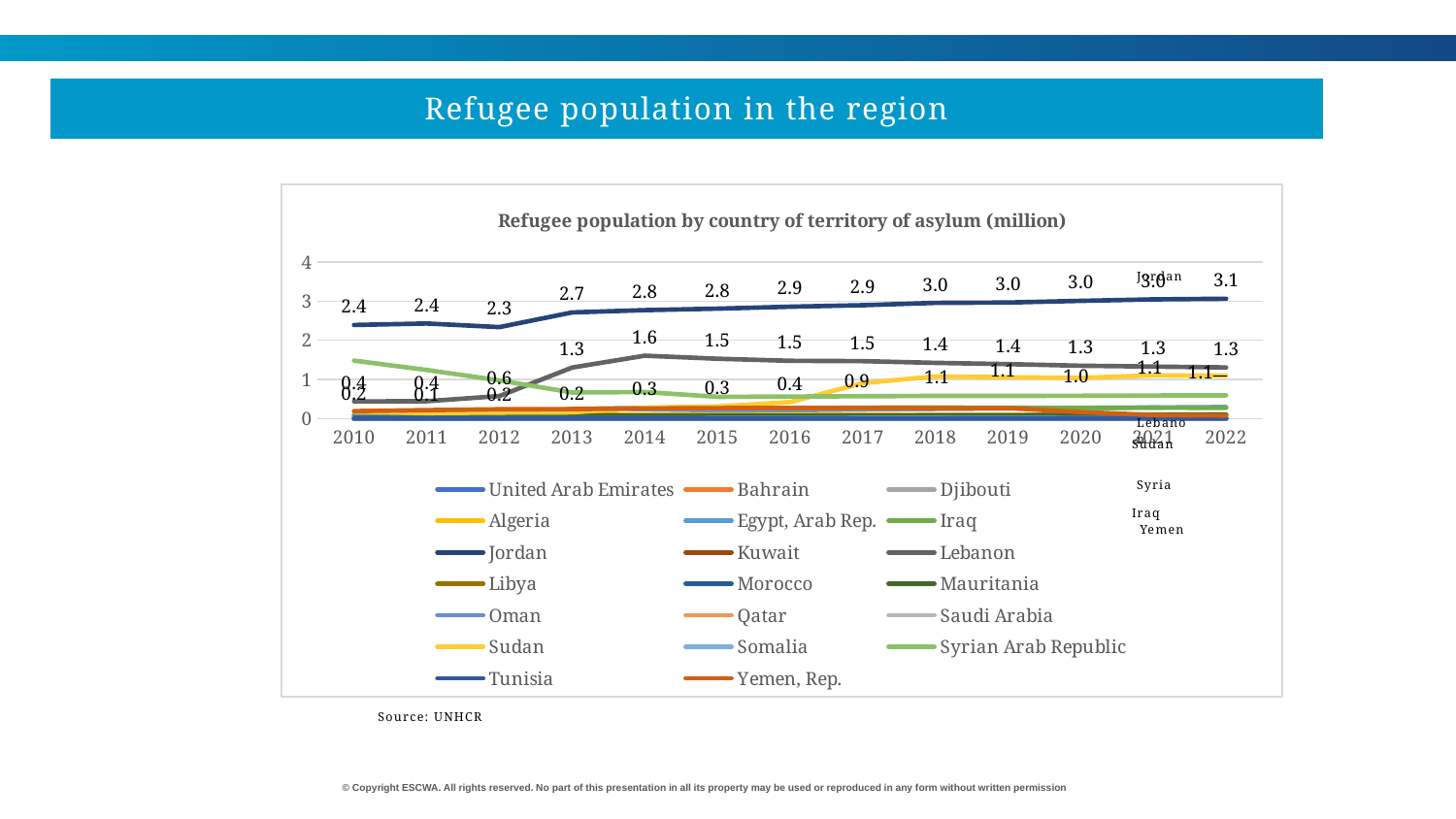
Does the refugee population for Jordan generally rise or fall from 2010 to 2022? rise What is the refugee population for Jordan in 2010? 2.4 How many countries does the chart legend list? 20 In which year is the refugee population for Jordan lowest? 2012 Which year has the larger refugee population for Jordan, 2012 or 2013? 2013 What is the refugee population for Jordan in 2022? 3.1 What kind of chart is shown on the slide? line chart By how much did the refugee population for Jordan increase from 2010 to 2022? 0.7 What is the title of the chart? Refugee population by country of territory of asylum (million) In which year is the refugee population for Jordan highest? 2022 How many years are shown along the x axis of the chart? 13 What is the refugee population for Jordan in 2014? 2.8